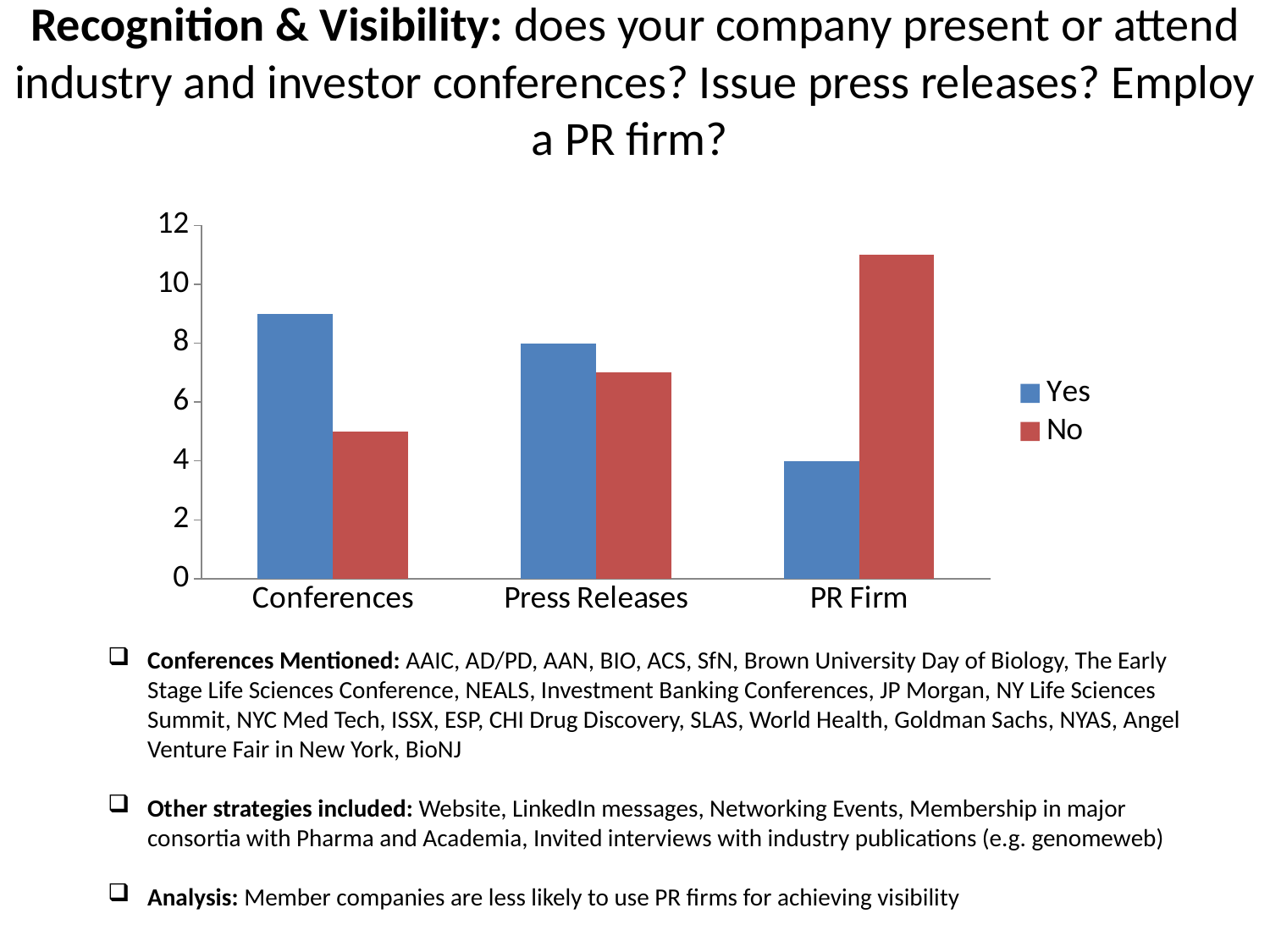
Is the value of the No series for Conferences greater or less than 6? less Which category has the lowest value in the Yes series? PR Firm How many categories are shown on the x axis? 3 For Conferences, which is larger, the Yes value or the No value? Yes What is the value of the Yes series for Press Releases? 8 Is the value of the No series for PR Firm greater or less than 10? greater How many series does the legend list? 2 Is the value of the Yes series for Conferences greater or less than 8? greater What is the value of the Yes series for PR Firm? 4 What colour are the bars for the No series? red What kind of chart is shown on the slide? bar chart Which category has the highest value in the No series? PR Firm